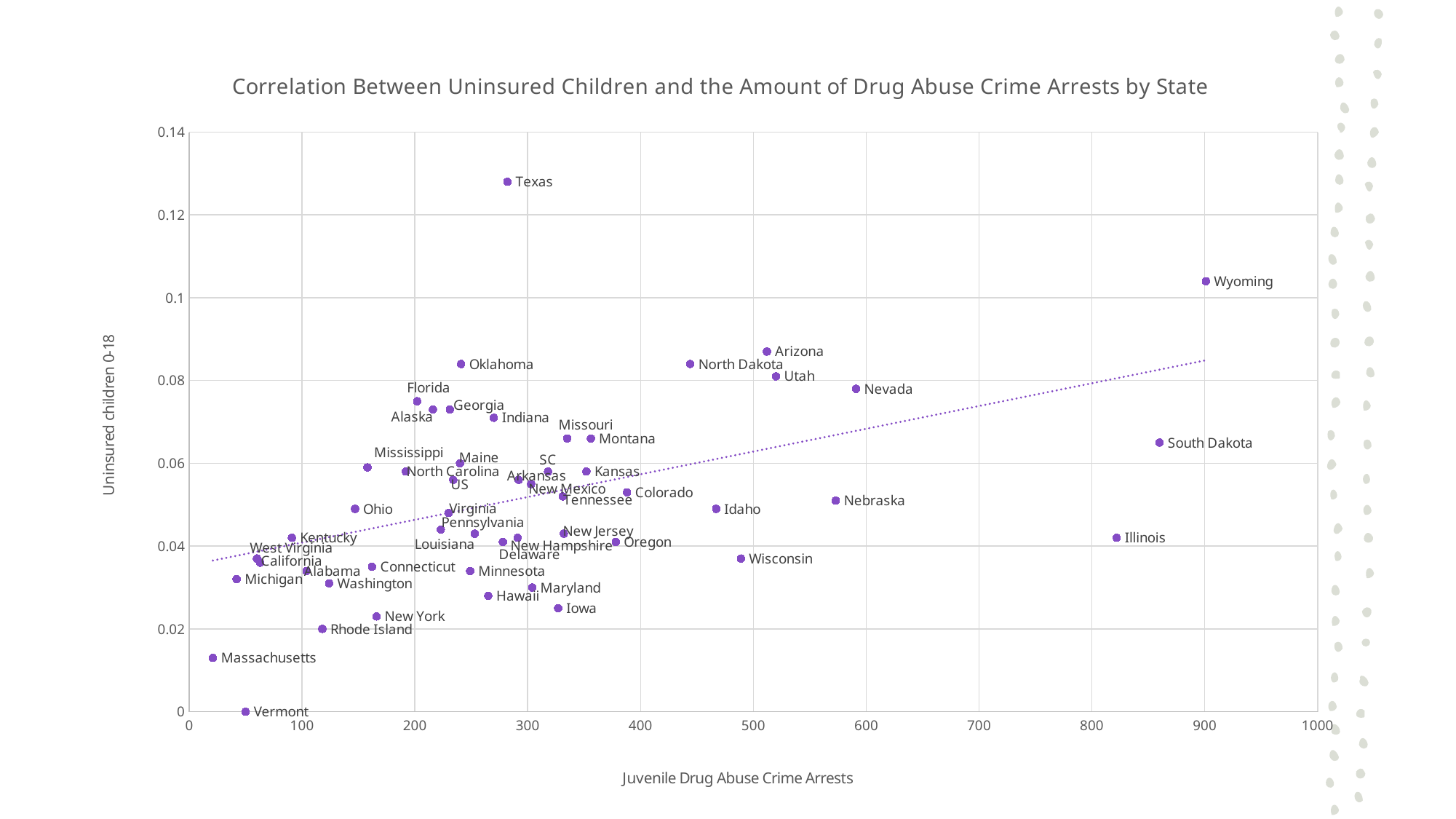
Is the uninsured children value for Wyoming greater or less than 0.1? greater What is the label of the x axis? Juvenile Drug Abuse Crime Arrests Is the uninsured children value for Texas greater or less than 0.12? greater Which state has the lowest value for uninsured children 0-18? Vermont Which state has the highest value for uninsured children 0-18? Texas What is the title of the chart? Correlation Between Uninsured Children and the Amount of Drug Abuse Crime Arrests by State What kind of chart is shown on the slide? scatter chart Is the uninsured children value for Massachusetts greater or less than 0.02? less Which state has the highest number of juvenile drug abuse crime arrests? Wyoming Which state has a higher uninsured children value, Arizona or Utah? Arizona According to the dotted trend line, do uninsured children values rise or fall as juvenile drug abuse crime arrests increase? rise